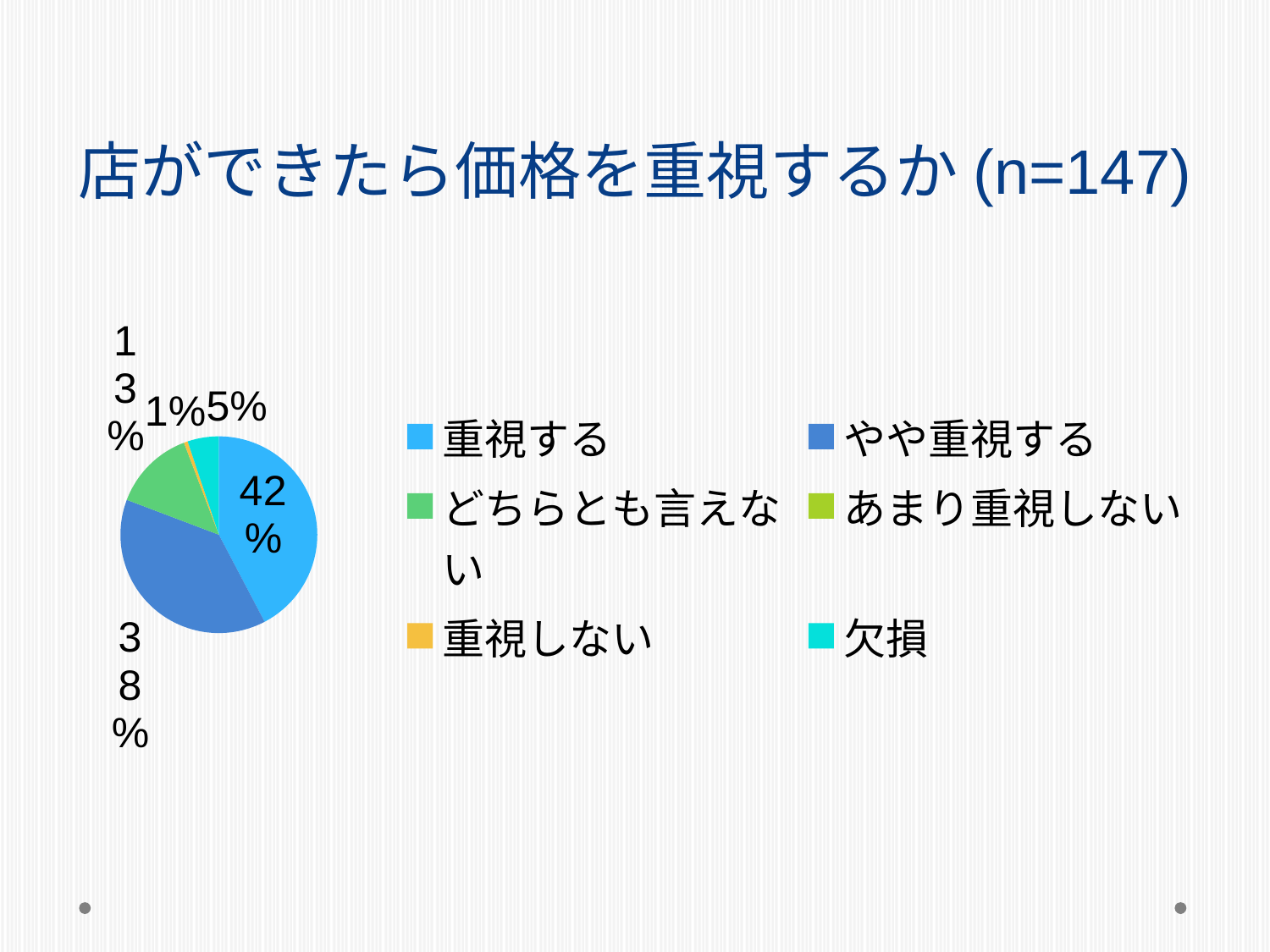
How many categories does the legend list? 6 What share of the pie is labelled for 重視する? 42% Which is larger, the slice for 重視する or the slice for やや重視する? 重視する What is the title of the chart? 店ができたら価格を重視するか (n=147) Which category has the largest slice of the pie? 重視する What kind of chart is shown on the slide? Pie chart What share of the pie is labelled for 欠損? 5% What is the difference between the shares for 重視する and やや重視する? 4 percentage points What share of the pie is labelled for どちらとも言えない? 13% What sample size (n) is given in the chart title? 147 What is the combined share of 重視する and やや重視する? 80% What share of the pie is labelled for やや重視する? 38%